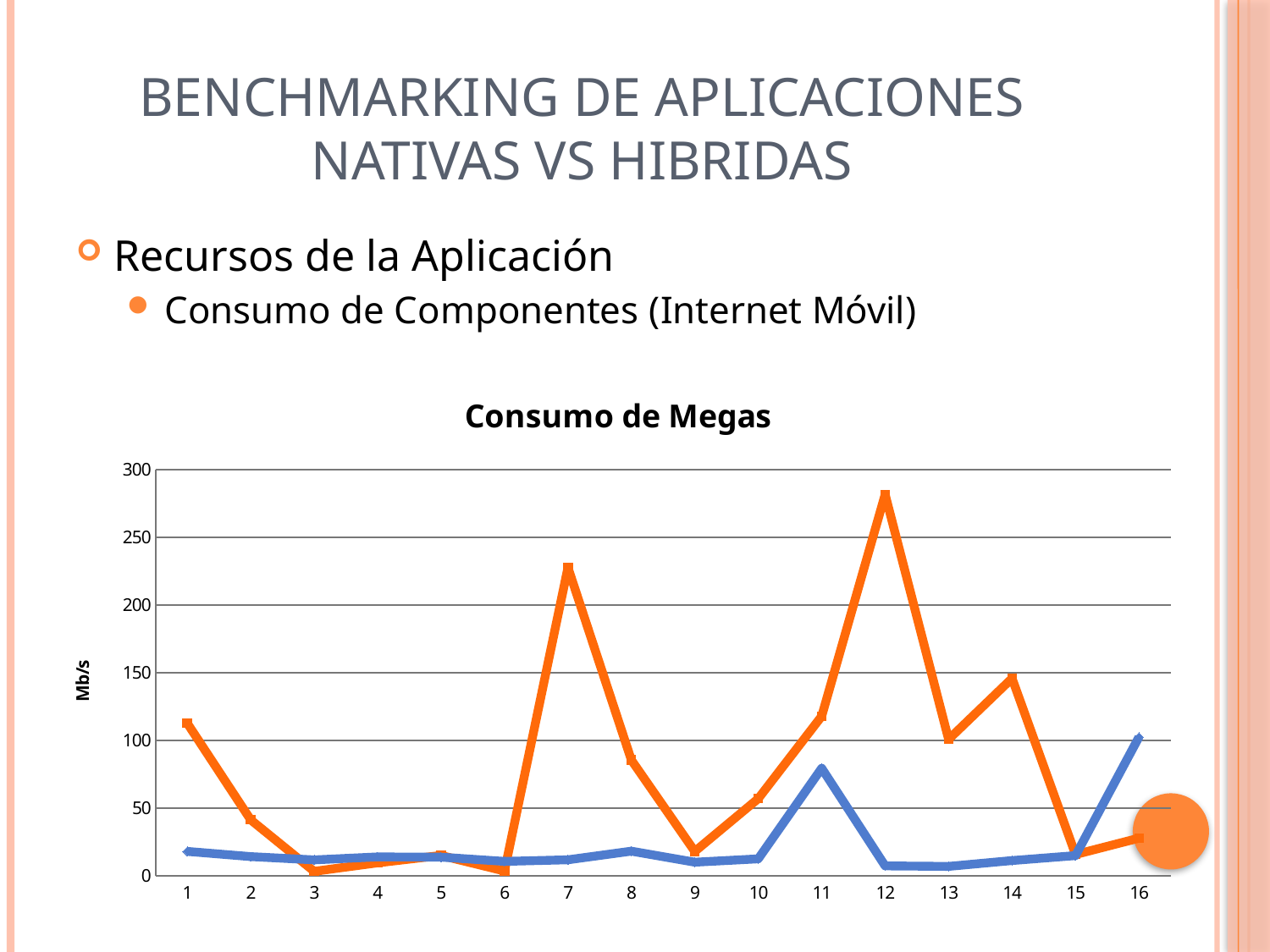
What kind of chart is shown on the slide? line chart Is the value of the orange line at point 12 greater or less than 250? greater What is the title of the chart? Consumo de Megas What is the label on the vertical axis of the chart? Mb/s How many lines are plotted on the chart? 2 At which x-axis point does the orange line reach its highest value? 12 How many points are plotted along the x axis for each line? 16 Does the orange line rise or fall between point 12 and point 13? fall At point 1, which line has the larger value, the orange line or the blue line? orange line Is the value of the orange line at point 7 greater or less than 200? greater Is the value of the blue line at point 11 greater or less than 100? less At which x-axis point does the blue line reach its highest value? 16